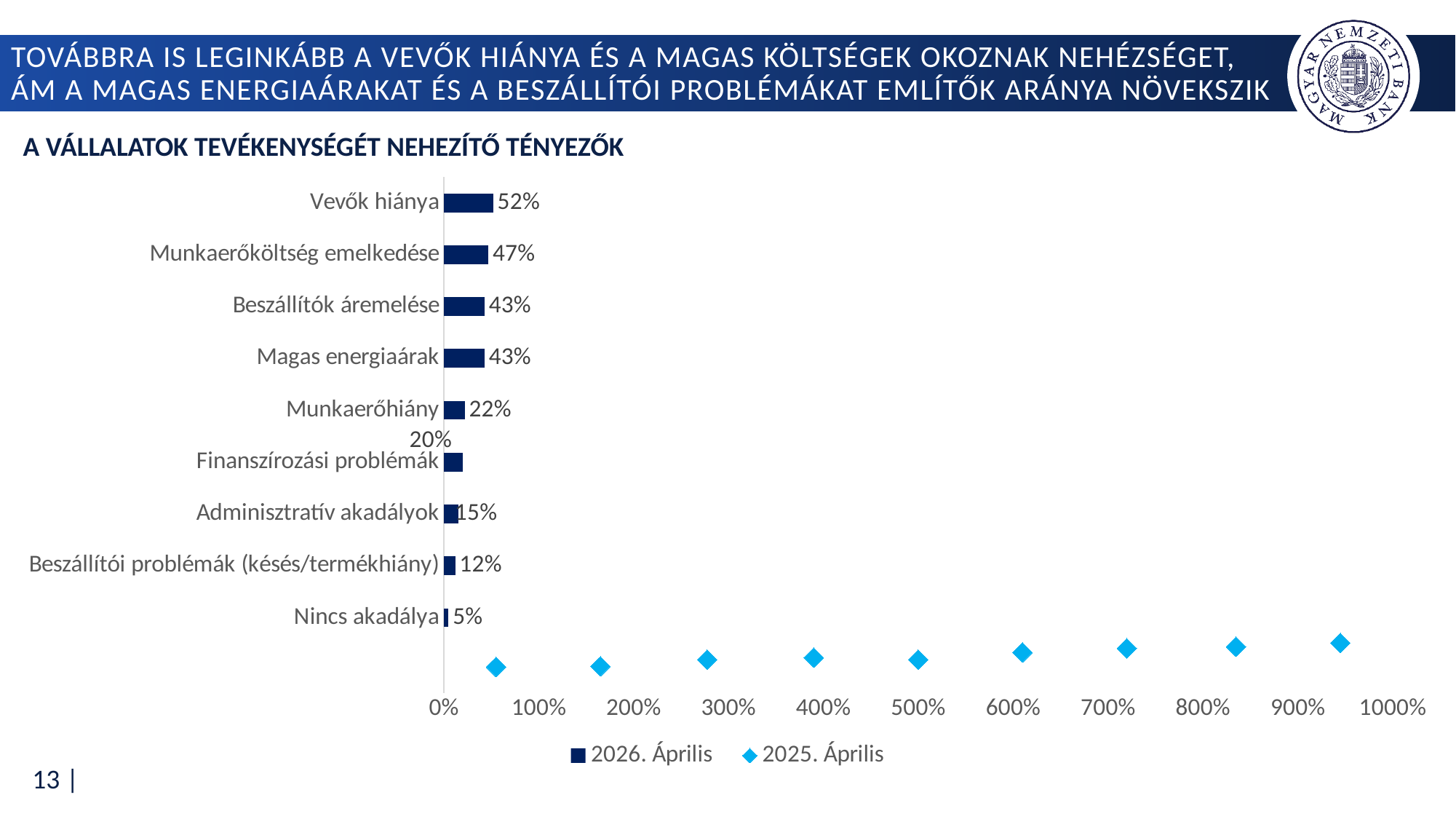
Which category has the highest 2026. Április value? Vevők hiánya Which category has the lowest 2026. Április value? Nincs akadálya What is the title of the chart? A vállalatok tevékenységét nehezítő tényezők What is the difference between the 2026. Április values for Vevők hiánya and Munkaerőhiány? 30% How many categories are shown on the chart? 9 What is the 2026. Április value for Vevők hiánya? 52% What kind of chart is shown on the slide? Bar chart What is the 2026. Április value for Munkaerőköltség emelkedése? 47% Which has a larger 2026. Április value, Munkaerőhiány or Adminisztratív akadályok? Munkaerőhiány What is the 2026. Április value for Magas energiaárak? 43% How many series does the legend list? 2 What is the 2026. Április value for Beszállítói problémák (késés/termékhiány)? 12%